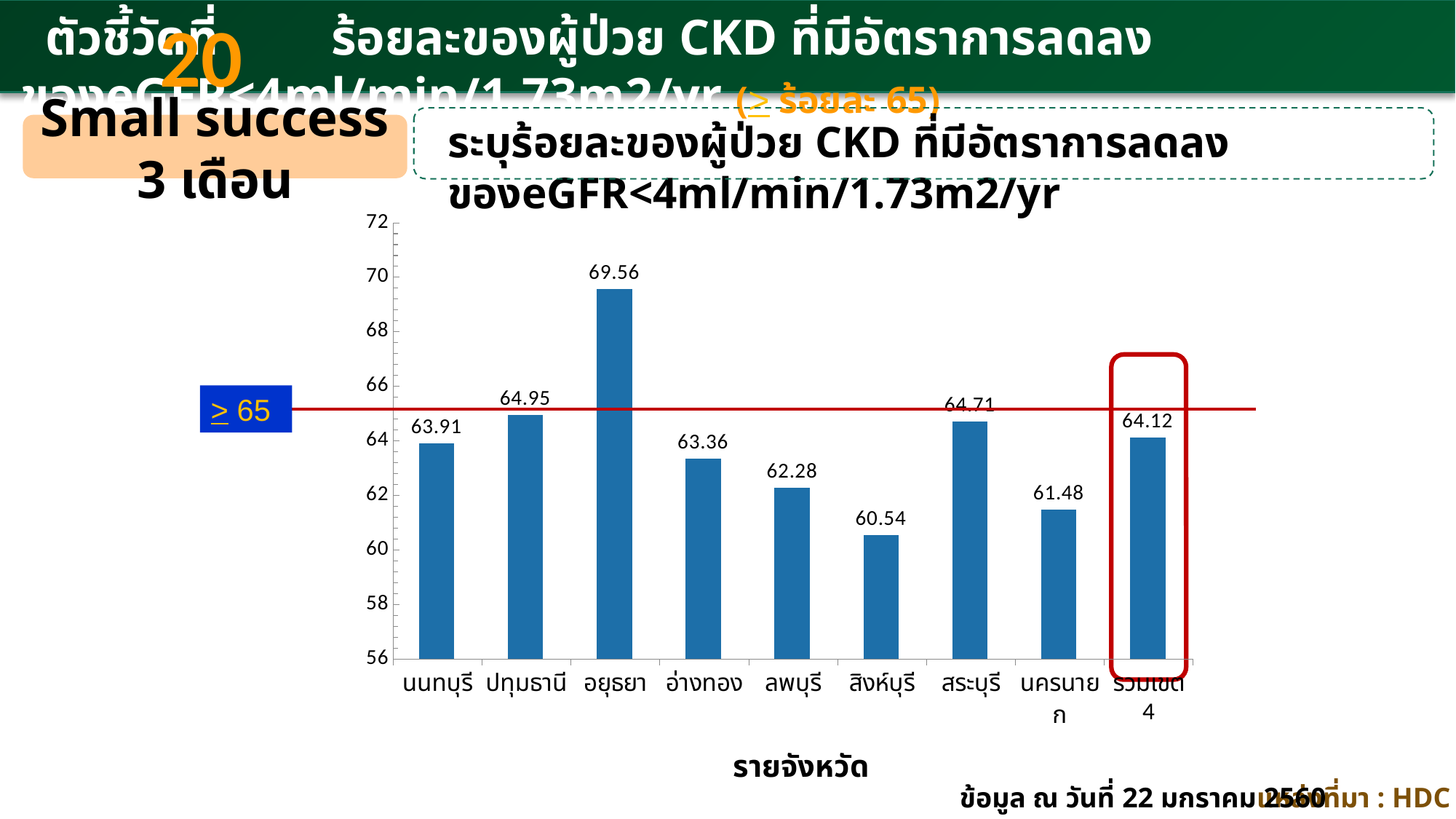
Is the value for ลพบุรี greater or less than 64? less Which category has the lowest value? สิงห์บุรี How many categories are shown on the x axis? 9 What kind of chart is shown on the slide? bar chart What is the value for อยุธยา? 69.56 What is the difference between the values for อยุธยา and สิงห์บุรี? 9.02 Which category has the highest value? อยุธยา What is the value for รวมเขต 4? 64.12 Which is larger, the value for ปทุมธานี or the value for สระบุรี? ปทุมธานี What is the x-axis title of the chart? รายจังหวัด What is the value for สิงห์บุรี? 60.54 What is the value for นครนายก? 61.48